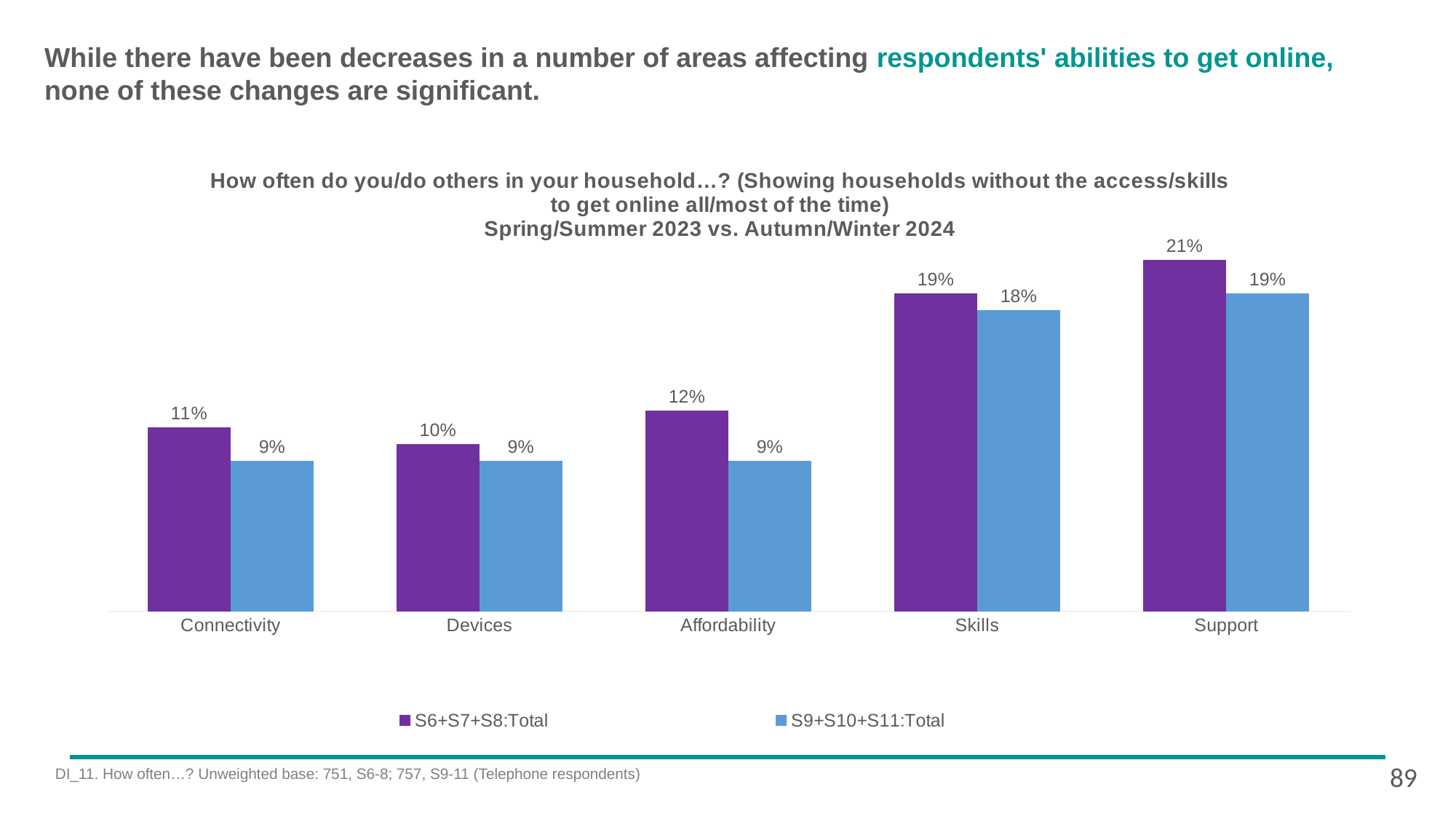
Which colour represents the S9+S10+S11:Total series? Blue How many categories are shown on the x axis? 5 Which category has the highest value in the S6+S7+S8:Total series? Support What is the value for Affordability in the S6+S7+S8:Total series? 12% How many series does the legend list? 2 What is the difference between the S6+S7+S8:Total and S9+S10+S11:Total values for Affordability? 3% What is the value for Skills in the S9+S10+S11:Total series? 18% What kind of chart is shown on the slide? Bar chart What is the difference between the S6+S7+S8:Total values for Support and Connectivity? 10% Which is larger: the S9+S10+S11:Total value for Skills or for Support? Support Which category has the lowest value in the S6+S7+S8:Total series? Devices What is the value for Connectivity in the S6+S7+S8:Total series? 11%